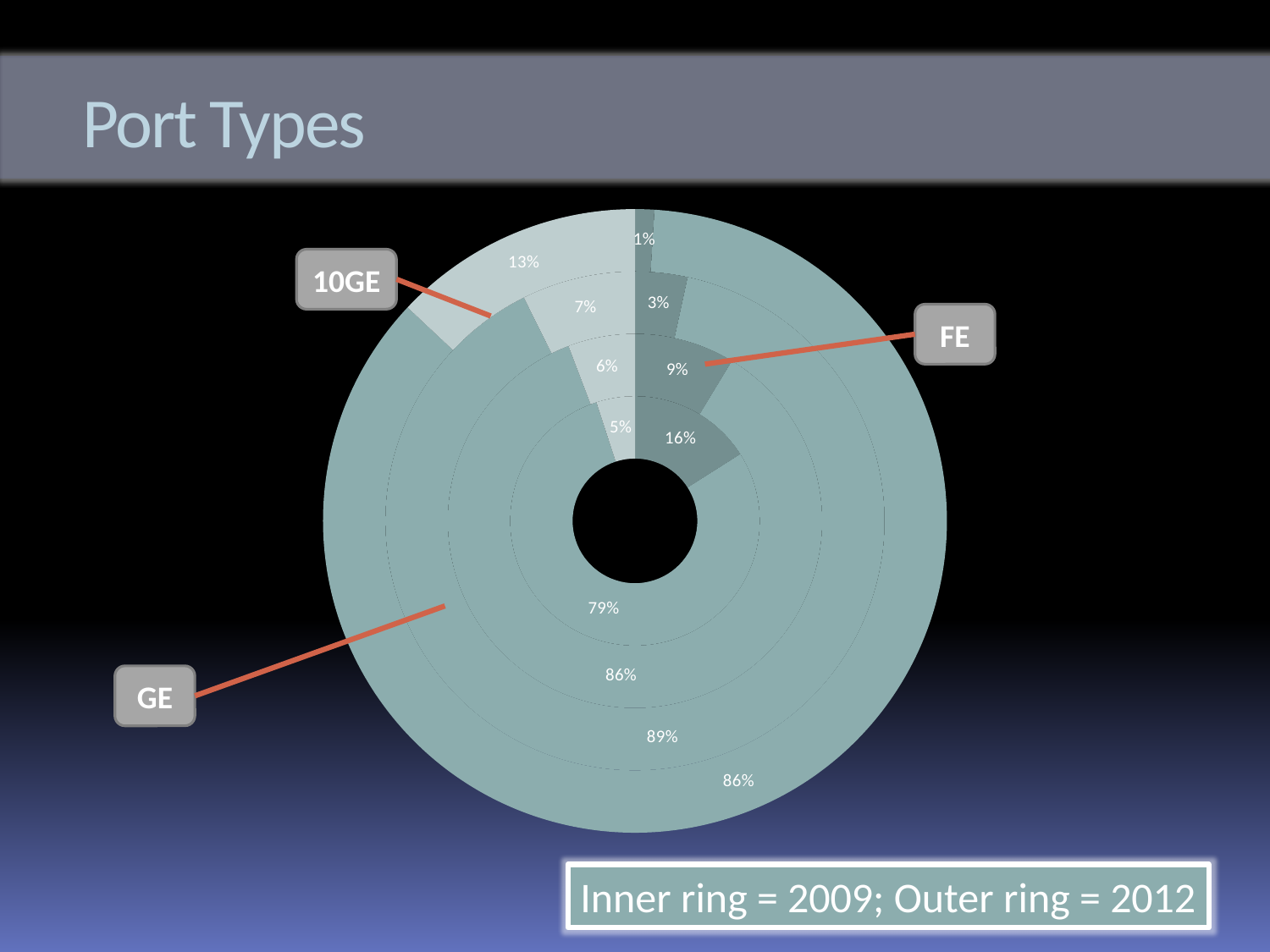
What is the share of 10GE ports in the outer ring (2012)? 13% What is the share of FE ports in the inner ring (2009)? 16% What is the share of GE ports in the inner ring (2009)? 79% What is the share of FE ports in the outer ring (2012)? 1% How many port type categories are shown in the chart? 3 What is the title of the chart? Port Types Which port type has the largest share in the outer ring (2012)? GE Does the share of 10GE ports rise or fall from the inner ring to the outer ring? rise Which port type has the smallest share in the inner ring (2009)? 10GE What kind of chart is shown on the slide? doughnut chart By how many percentage points did the FE share fall from the inner ring (2009) to the outer ring (2012)? 15 How many rings does the doughnut chart have? 4